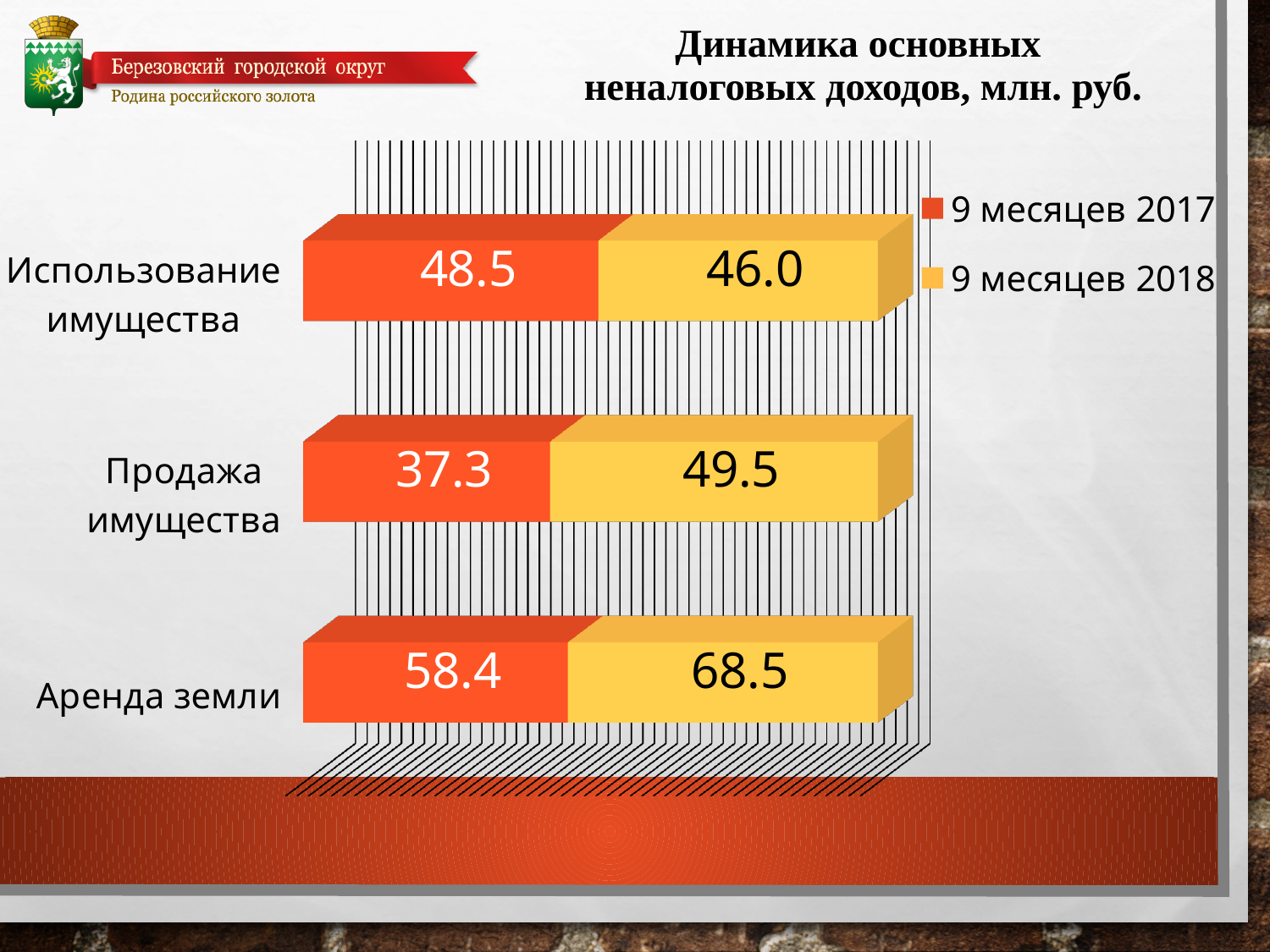
What is the difference between the 9 месяцев 2018 and 9 месяцев 2017 values for Аренда земли? 10.1 What is the value for 9 месяцев 2018 in the Продажа имущества category? 49.5 How many categories are shown in the chart? 3 What is the value for 9 месяцев 2017 in the Аренда земли category? 58.4 What is the total of the stacked bar for Продажа имущества? 86.8 Which category has the lowest value for 9 месяцев 2017? Продажа имущества What kind of chart is shown on the slide? Stacked bar chart How many series does the legend list? 2 Which category has the highest value for 9 месяцев 2018? Аренда земли What is the value for 9 месяцев 2018 in the Аренда земли category? 68.5 What is the value for 9 месяцев 2017 in the Использование имущества category? 48.5 Which is larger for Использование имущества: the 9 месяцев 2017 value or the 9 месяцев 2018 value? 9 месяцев 2017